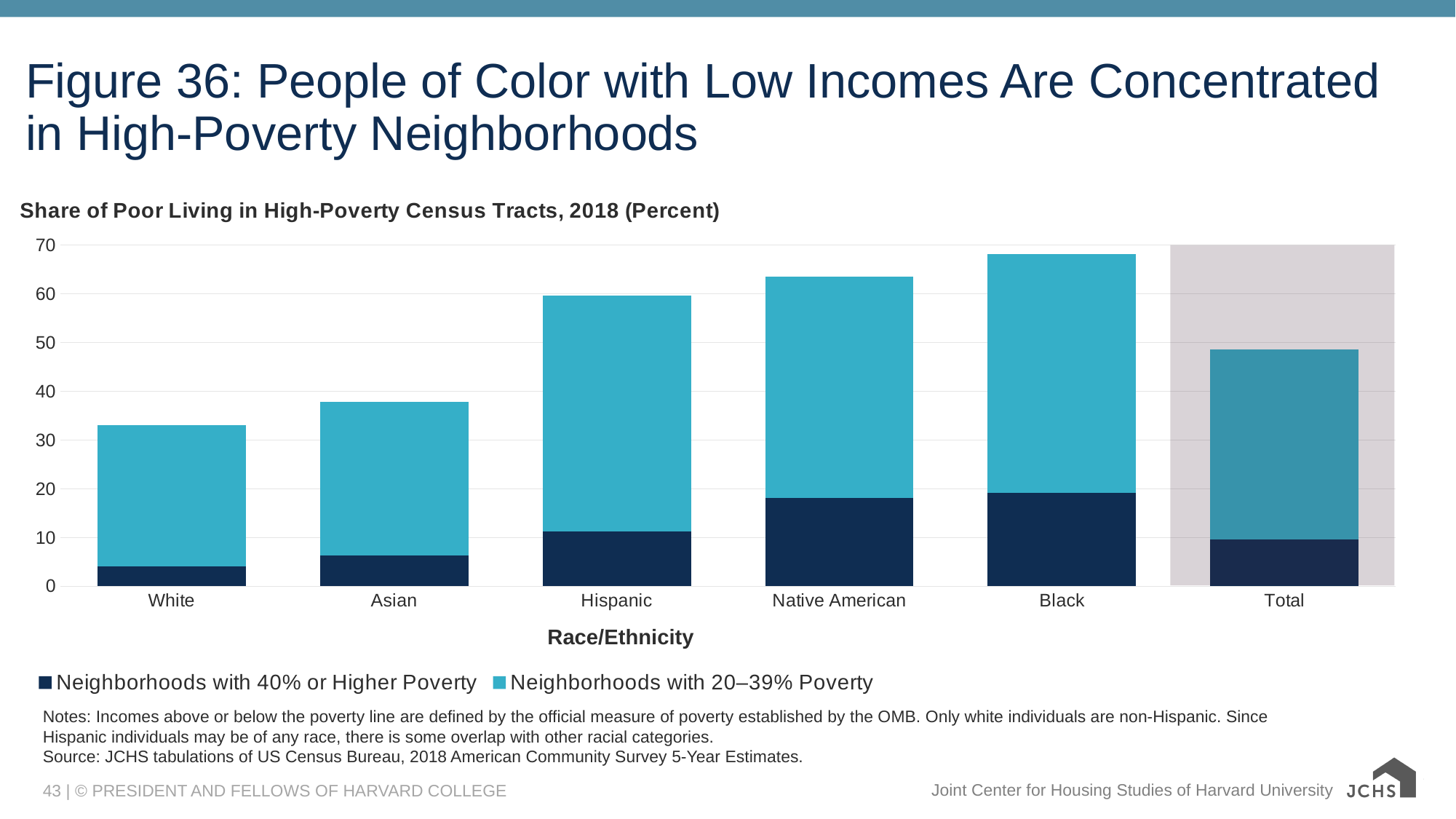
Is the total stacked bar for White greater or less than 30? greater What kind of chart is shown on the slide? Stacked bar chart Which race/ethnicity category has the tallest stacked bar? Black How many race/ethnicity categories are shown on the x axis? 6 How many series does the legend list? 2 Is the total stacked bar for Total greater or less than 50? less Is the 'Neighborhoods with 40% or Higher Poverty' segment for Hispanic greater or less than 10? greater Which has a taller stacked bar, Hispanic or Asian? Hispanic Which race/ethnicity category has the shortest stacked bar? White What is the x-axis title of the chart? Race/Ethnicity